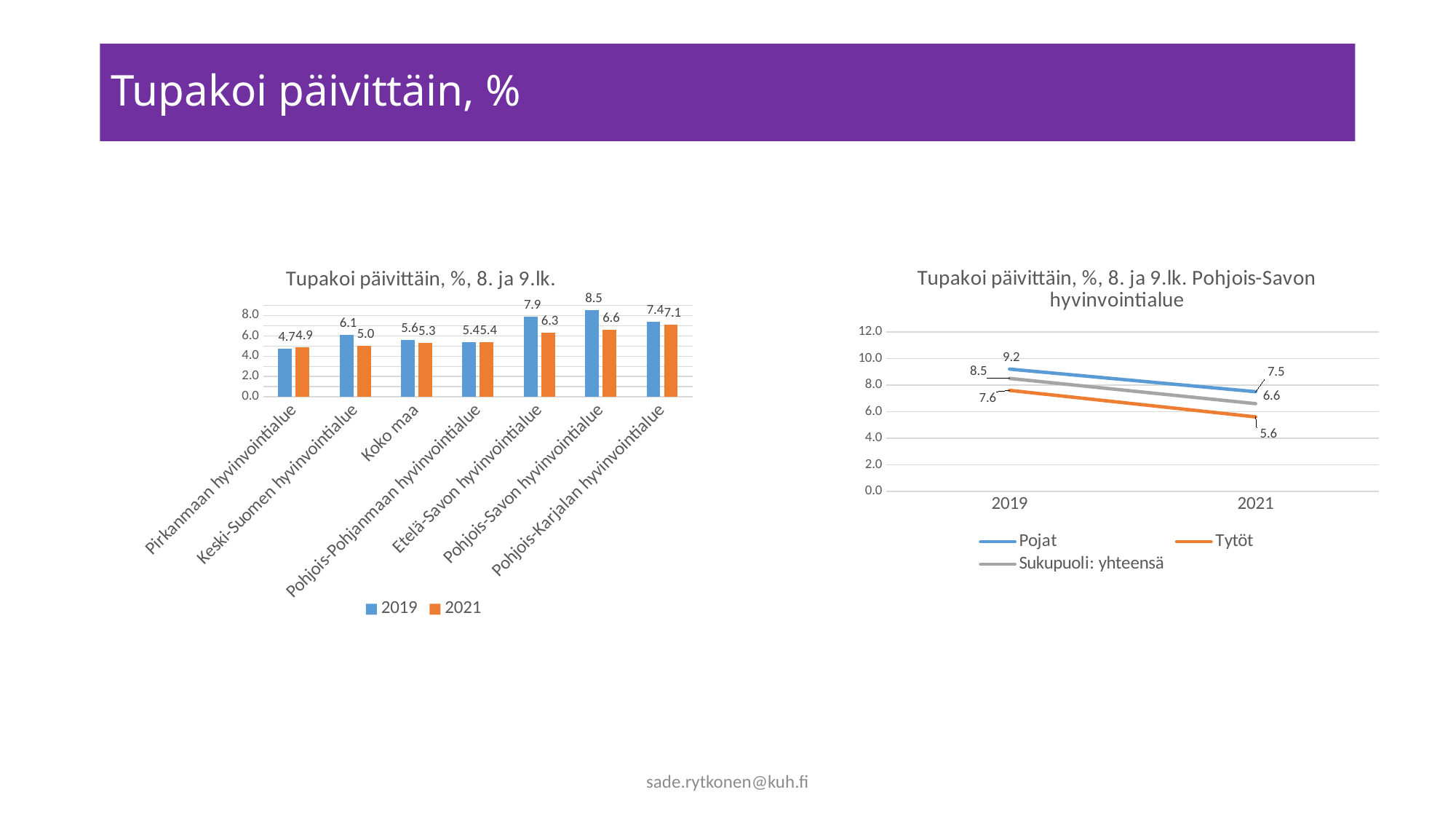
How many series does the legend of the right chart 'Tupakoi päivittäin, %, 8. ja 9.lk. Pohjois-Savon hyvinvointialue' list? 3 In the left chart 'Tupakoi päivittäin, %, 8. ja 9.lk.', which is larger for Keski-Suomen hyvinvointialue: the 2019 value or the 2021 value? 2019 In the left chart 'Tupakoi päivittäin, %, 8. ja 9.lk.', which category has the lowest 2021 value? Pirkanmaan hyvinvointialue In the left chart 'Tupakoi päivittäin, %, 8. ja 9.lk.', what is the 2021 value for Koko maa? 5.3 What type of chart is the left chart 'Tupakoi päivittäin, %, 8. ja 9.lk.'? Bar chart In the left chart 'Tupakoi päivittäin, %, 8. ja 9.lk.', what is the difference between the 2019 and 2021 values for Etelä-Savon hyvinvointialue? 1.6 In the right chart 'Tupakoi päivittäin, %, 8. ja 9.lk. Pohjois-Savon hyvinvointialue', does the Sukupuoli: yhteensä line rise or fall from 2019 to 2021? Fall In the right chart 'Tupakoi päivittäin, %, 8. ja 9.lk. Pohjois-Savon hyvinvointialue', what is the value for Pojat in 2019? 9.2 How many categories are shown on the x axis of the left chart 'Tupakoi päivittäin, %, 8. ja 9.lk.'? 7 In the left chart 'Tupakoi päivittäin, %, 8. ja 9.lk.', what is the 2019 value for Pohjois-Savon hyvinvointialue? 8.5 In the right chart 'Tupakoi päivittäin, %, 8. ja 9.lk. Pohjois-Savon hyvinvointialue', what is the value for Tytöt in 2021? 5.6 In the left chart 'Tupakoi päivittäin, %, 8. ja 9.lk.', which category has the highest 2019 value? Pohjois-Savon hyvinvointialue